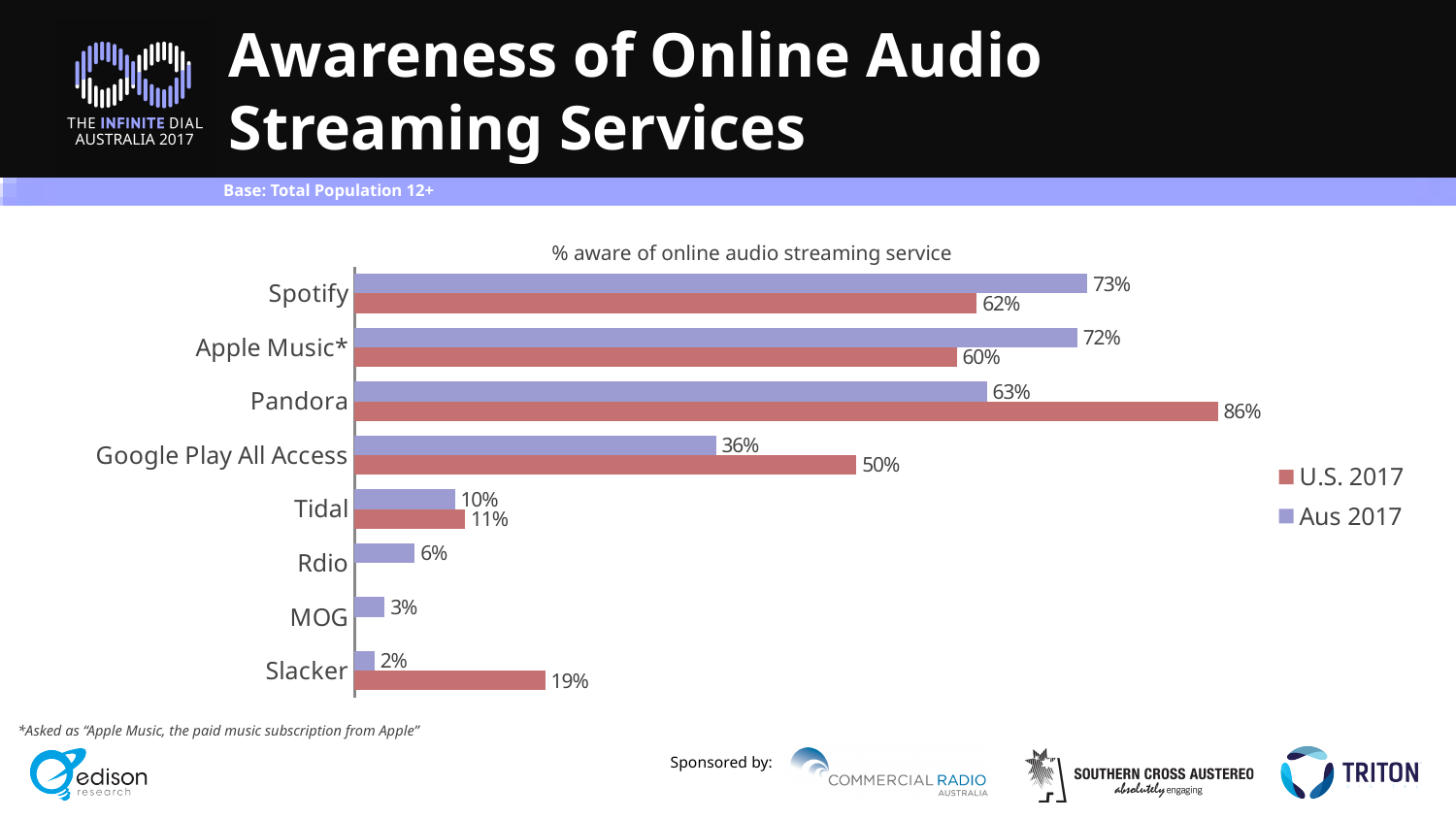
For Apple Music, which is larger: the Aus 2017 value or the U.S. 2017 value? Aus 2017 What percentage of Australians in 2017 were aware of Spotify? 73% What is the Aus 2017 awareness value for Google Play All Access? 36% What is the U.S. 2017 awareness value for Slacker? 19% Which service has the highest Aus 2017 awareness? Spotify How many series does the legend list? 2 Which colour represents the U.S. 2017 series in the legend? Red What type of chart is shown on the slide? Bar chart What is the difference between the U.S. 2017 and Aus 2017 awareness values for Pandora? 23 percentage points What is the U.S. 2017 awareness value for Pandora? 86% How many streaming services are listed on the chart? 8 Which service has the lowest Aus 2017 awareness? Slacker